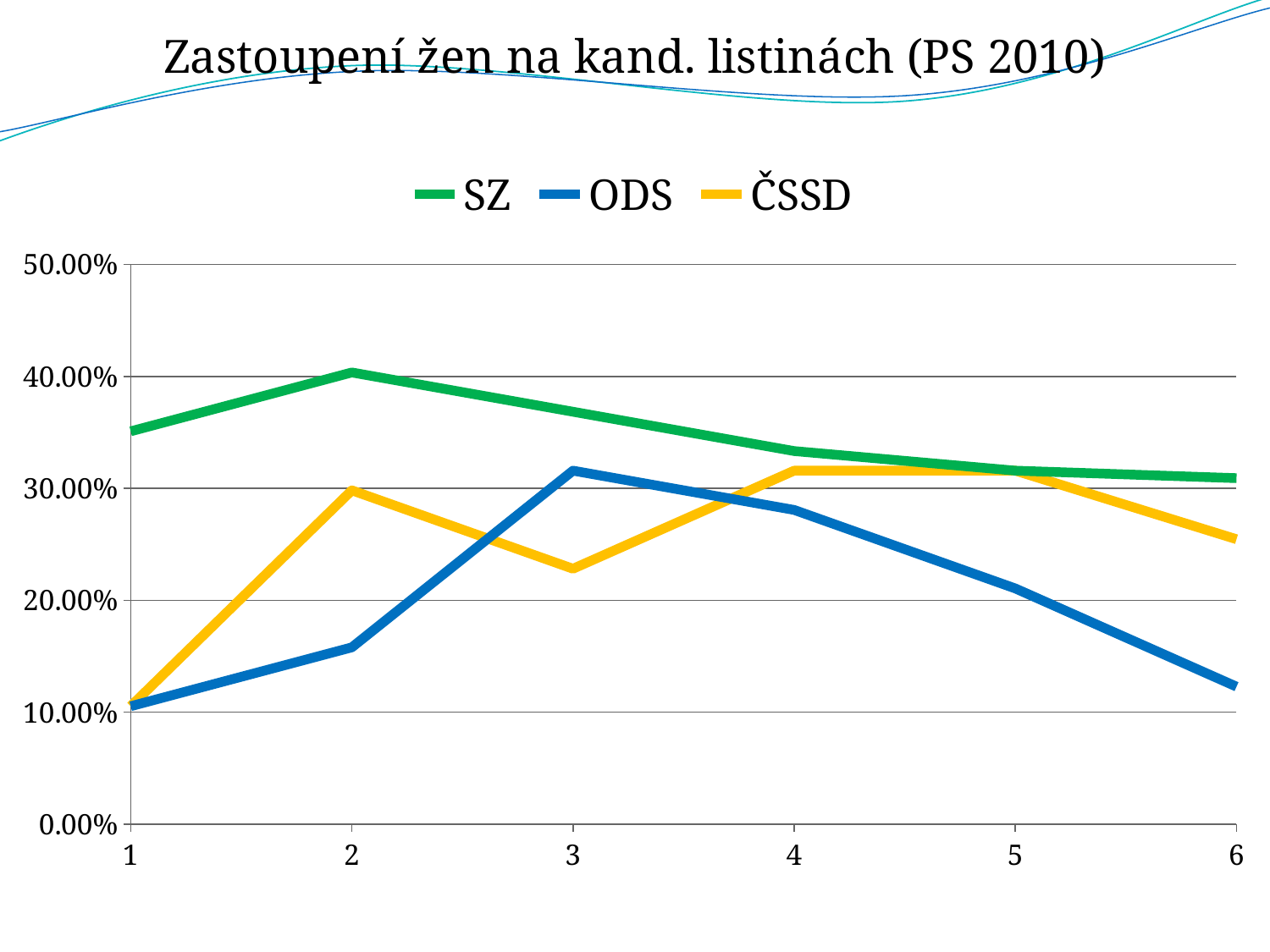
At which x-axis position does the SZ series reach its highest value? 2 How many series does the legend list? 3 At which x-axis position does the ČSSD series have its lowest value? 1 Does the ODS series rise or fall from position 3 to position 6? fall Is the value for ODS at position 6 greater or less than 20.00%? less Is the value for ČSSD at position 3 greater or less than 20.00%? greater What is the title of the chart? Zastoupení žen na kand. listinách (PS 2010) At position 3, which series has the larger value, ODS or ČSSD? ODS What kind of chart is shown on the slide? line chart Is the value for ODS at position 1 greater or less than 20.00%? less How many points are plotted along the x axis for each series? 6